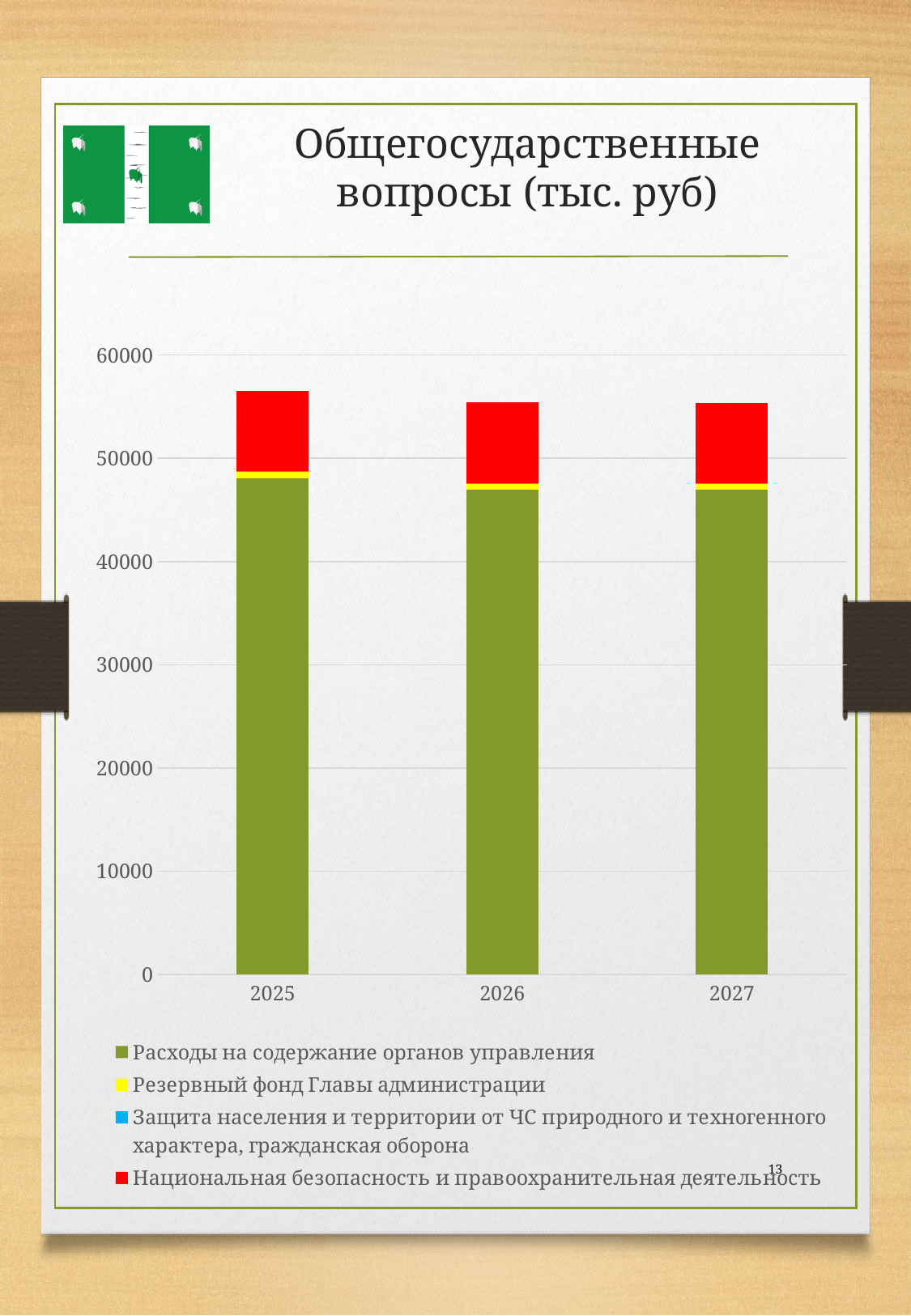
Which year has the highest total stacked bar? 2025 Is the value of Расходы на содержание органов управления for 2025 greater or less than 40000? greater Which legend entry is shown in red? Национальная безопасность и правоохранительная деятельность Is the value of Расходы на содержание органов управления for 2027 greater or less than 50000? less How many series does the chart legend list? 4 Is the total height of the stacked bar for 2025 greater or less than 50000? greater Which series forms the largest segment of each stacked bar? Расходы на содержание органов управления How many years are shown on the x axis of the chart? 3 What is the title of the chart? Общегосударственные вопросы (тыс. руб) Do the total stacked bar heights rise or fall from 2025 to 2027? fall What kind of chart is shown on the slide? bar chart